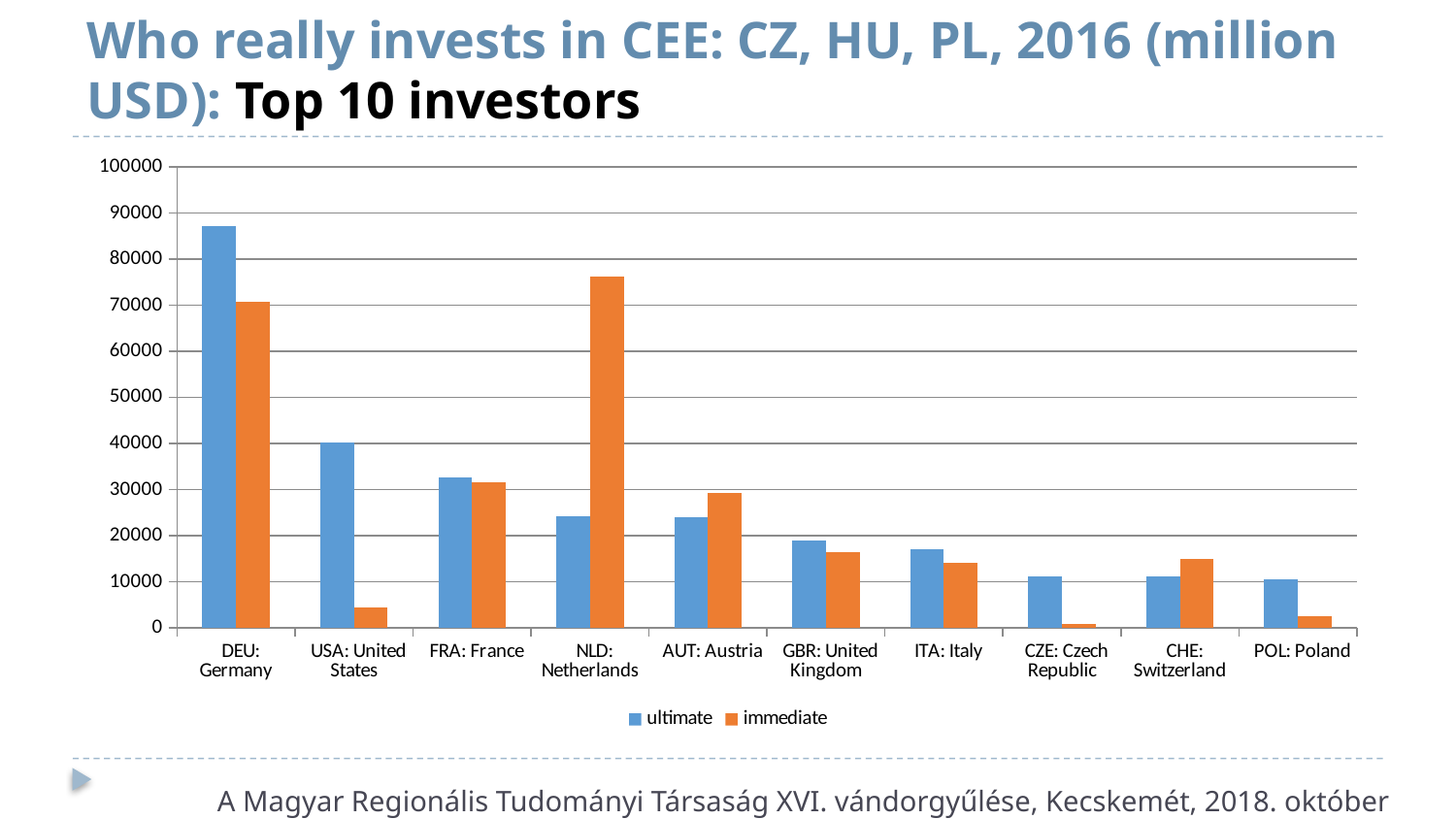
How many investor countries are shown on the x axis? 10 What kind of chart is shown on the slide? bar chart Which country has the lowest 'immediate' value? CZE: Czech Republic Is the 'ultimate' value for DEU: Germany greater or less than 80000? greater For USA: United States, which is larger, the 'ultimate' or the 'immediate' value? ultimate How many series does the legend list? 2 Which country has the highest 'immediate' value? NLD: Netherlands Is the 'immediate' value for NLD: Netherlands greater or less than 70000? greater Is the 'immediate' value for USA: United States greater or less than 10000? less For CHE: Switzerland, which is larger, the 'ultimate' or the 'immediate' value? immediate What are the two series named in the legend? ultimate and immediate Which country has the highest 'ultimate' value? DEU: Germany